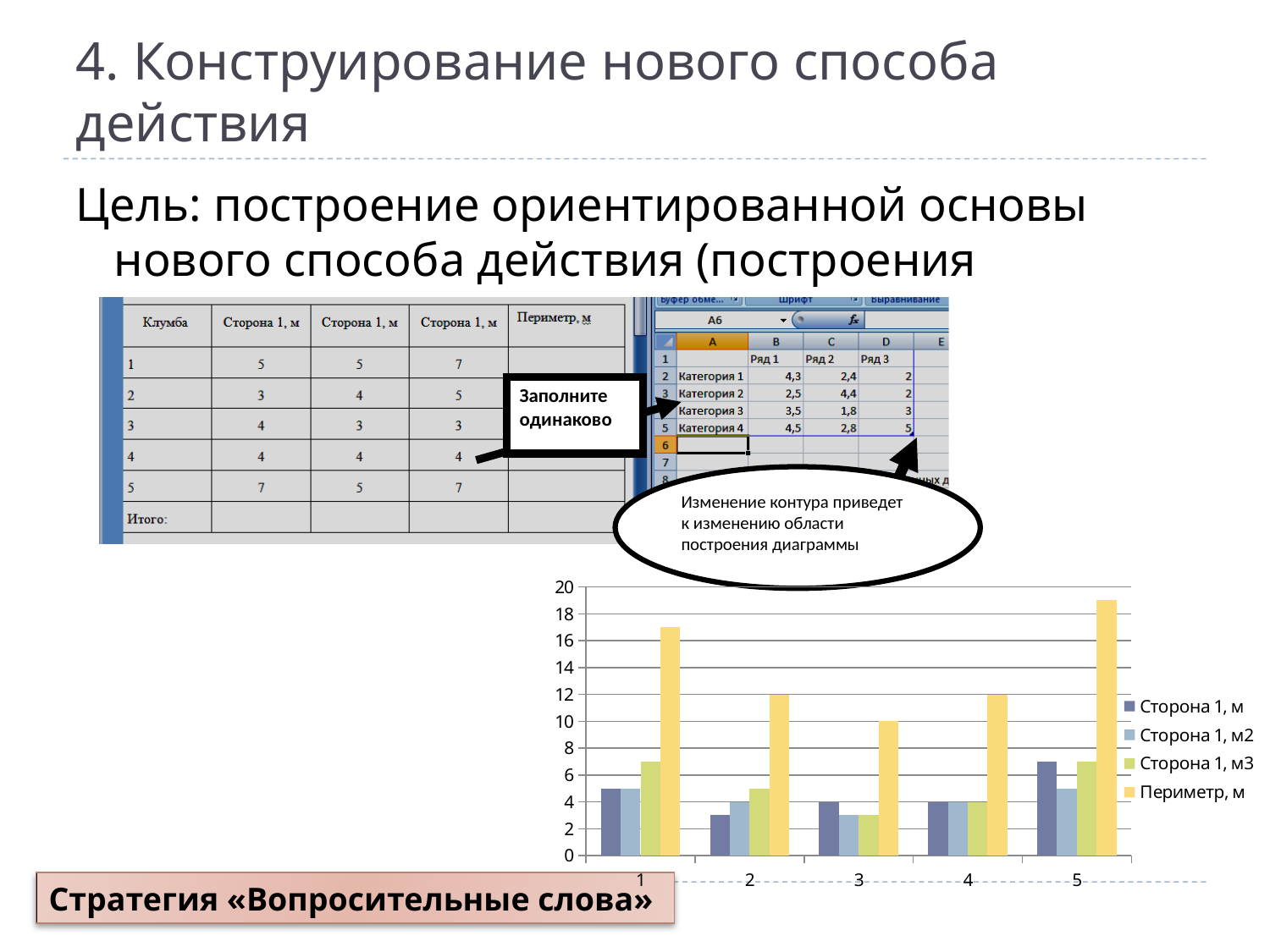
Is the value of Периметр, м for category 5 greater or less than 18? greater How many categories are shown along the x axis of the chart? 5 What is the value of Периметр, м for category 3? 10 Is the value of Сторона 1, м for category 2 greater or less than 4? less For which category is Периметр, м the lowest? 3 For which category is Периметр, м the highest? 5 Which is larger: Периметр, м for category 1 or for category 2? category 1 Which legend entry is shown in yellow? Периметр, м What is the value of Сторона 1, м for category 4? 4 What is the value of Периметр, м for category 2? 12 How many series does the chart legend list? 4 What kind of chart is shown on the slide? bar chart